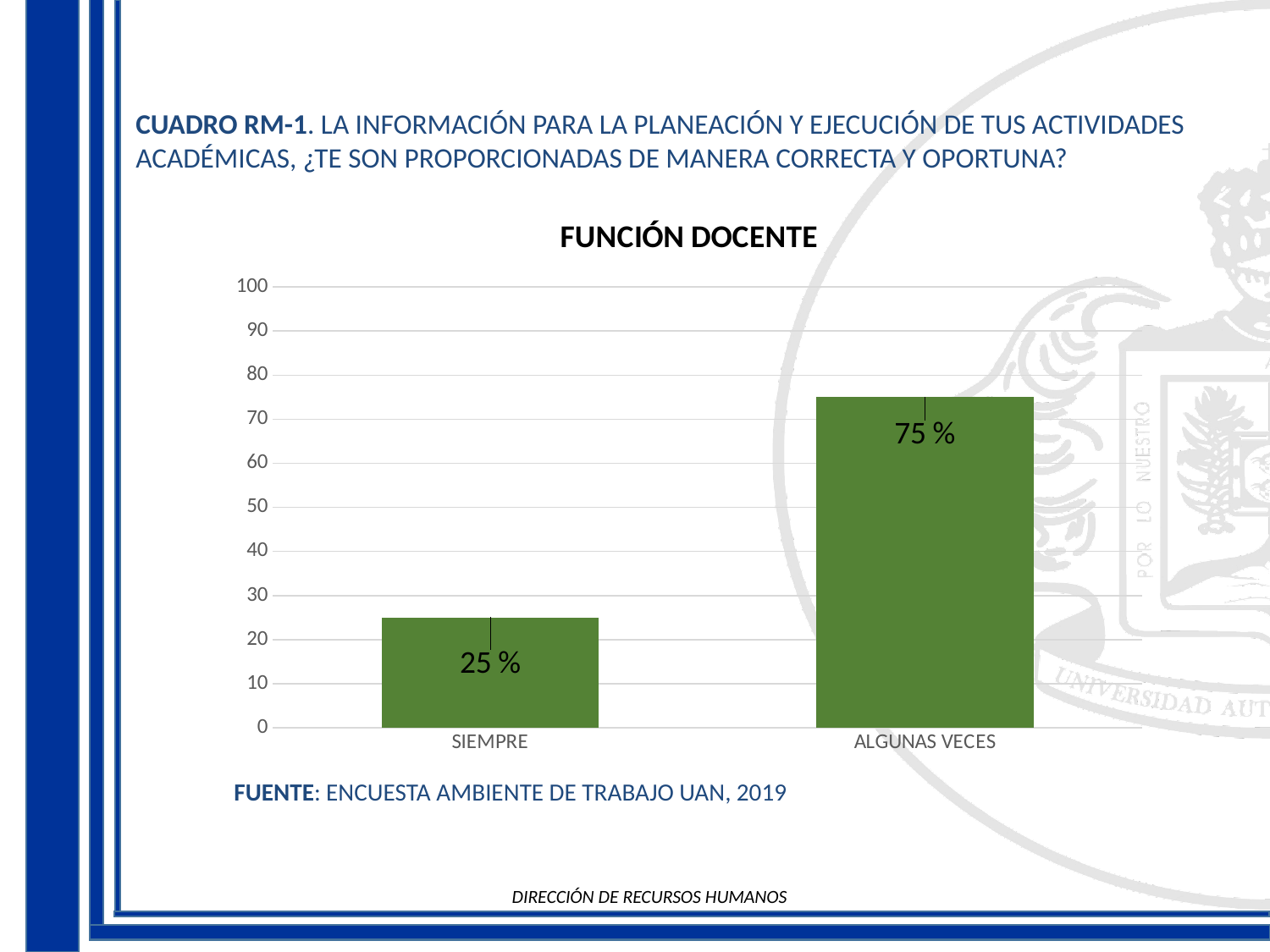
What is the difference between the values for ALGUNAS VECES and SIEMPRE? 50 % What is the value for ALGUNAS VECES? 75 % Is the value for SIEMPRE greater or less than 30? less What is the maximum value shown on the y axis? 100 Which category has the lowest value? SIEMPRE Is the value for ALGUNAS VECES greater or less than 50? greater Which category has the highest value? ALGUNAS VECES How many categories are shown on the x axis? 2 What is the title of the chart? FUNCIÓN DOCENTE Which is larger, the value for SIEMPRE or the value for ALGUNAS VECES? ALGUNAS VECES What is the value for SIEMPRE? 25 % What kind of chart is shown on the slide? bar chart